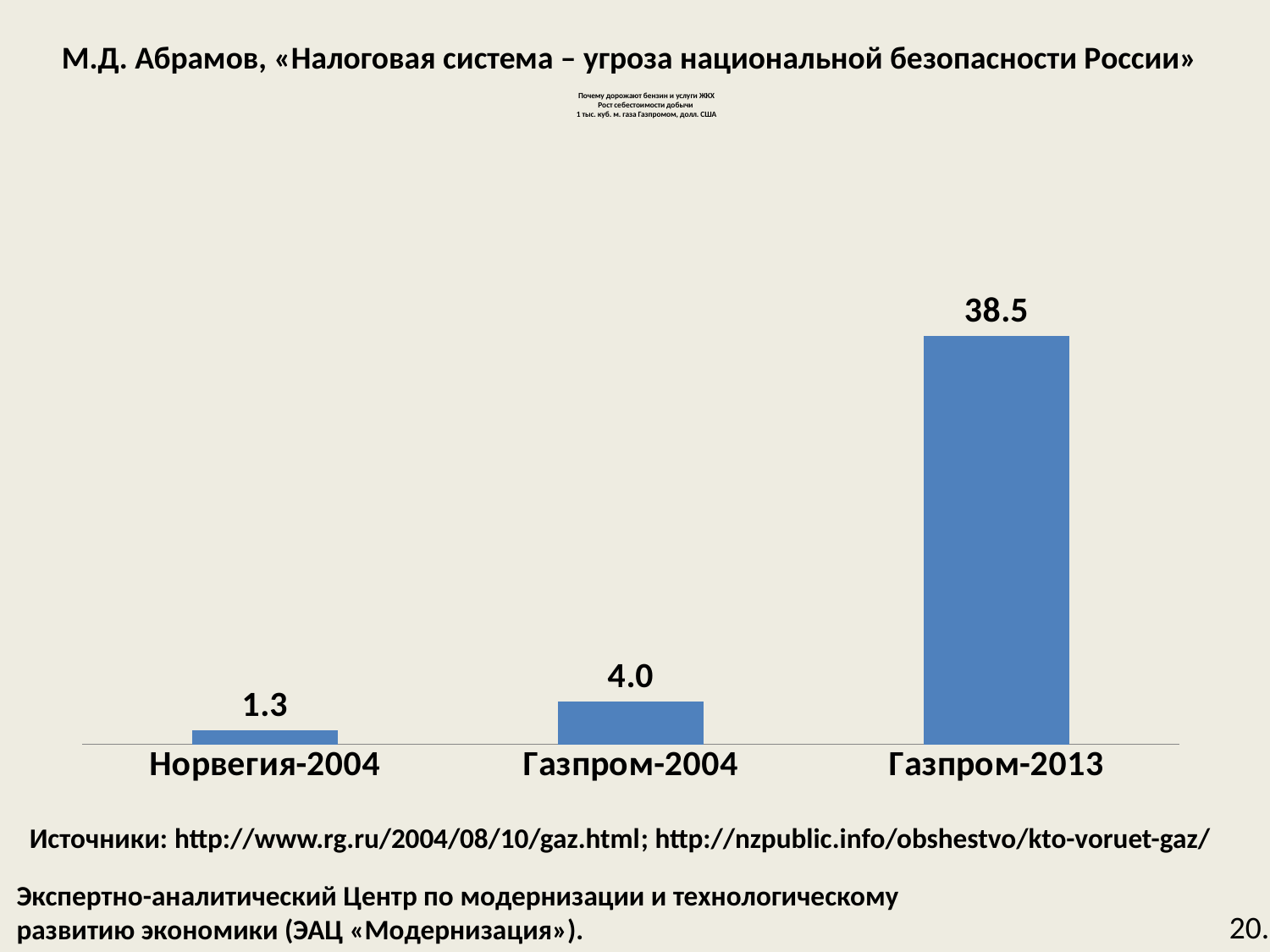
What is the difference between the values for Газпром-2013 and Газпром-2004? 34.5 Do the values rise or fall from left to right along the x axis? Rise Which category has the lowest value? Норвегия-2004 What is the value for Газпром-2004? 4.0 What colour are the bars in the chart? Blue What kind of chart is shown on the slide? Bar chart Which is larger, the value for Газпром-2004 or the value for Норвегия-2004? Газпром-2004 What is the difference between the values for Газпром-2004 and Норвегия-2004? 2.7 How many categories are shown on the chart? 3 What is the value for Норвегия-2004? 1.3 Which category has the highest value? Газпром-2013 What is the value for Газпром-2013? 38.5